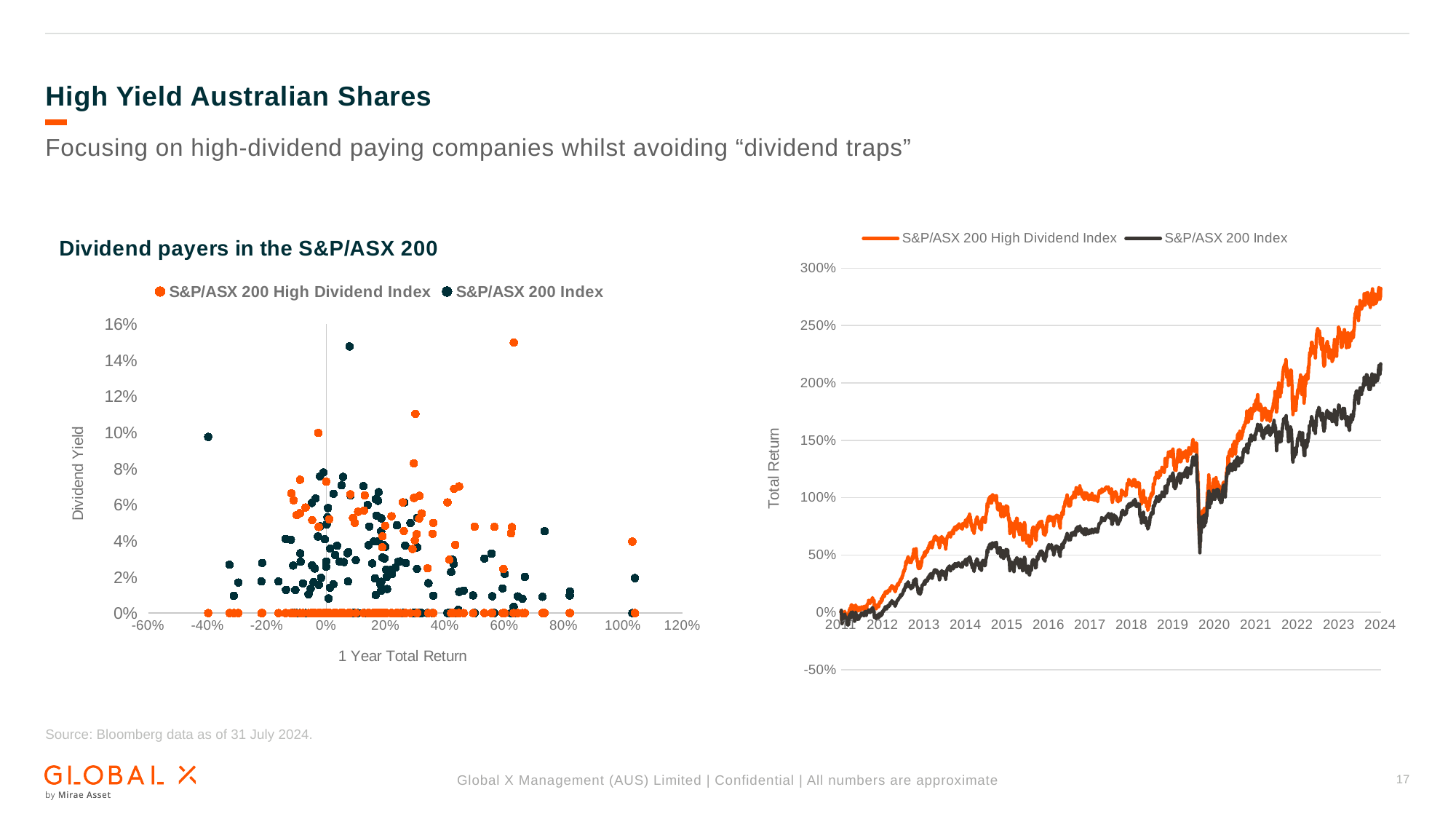
In the right chart (Total Return over time), do the values of the S&P/ASX 200 High Dividend Index generally rise or fall from 2011 to 2024? Rise What is the x-axis label of the left chart "Dividend payers in the S&P/ASX 200"? 1 Year Total Return In the right chart (Total Return over time), is the value of the S&P/ASX 200 Index at 2024 greater or less than 250%? less In the right chart (Total Return over time), which series is higher at 2024: the S&P/ASX 200 High Dividend Index or the S&P/ASX 200 Index? S&P/ASX 200 High Dividend Index What kind of chart is the right chart showing Total Return from 2011 to 2024? Line chart How many series does the legend of the right chart (Total Return over time) list? 2 In the right chart (Total Return over time), is the value of the S&P/ASX 200 Index at 2016 greater or less than 100%? less How many series does the legend of the left chart "Dividend payers in the S&P/ASX 200" list? 2 How many year labels are shown on the x axis of the right chart (Total Return over time)? 14 In the right chart (Total Return over time), which series is plotted in orange? S&P/ASX 200 High Dividend Index What kind of chart is the left chart titled "Dividend payers in the S&P/ASX 200"? Scatter chart In the right chart (Total Return over time), is the value of the S&P/ASX 200 High Dividend Index at 2024 greater or less than 250%? greater